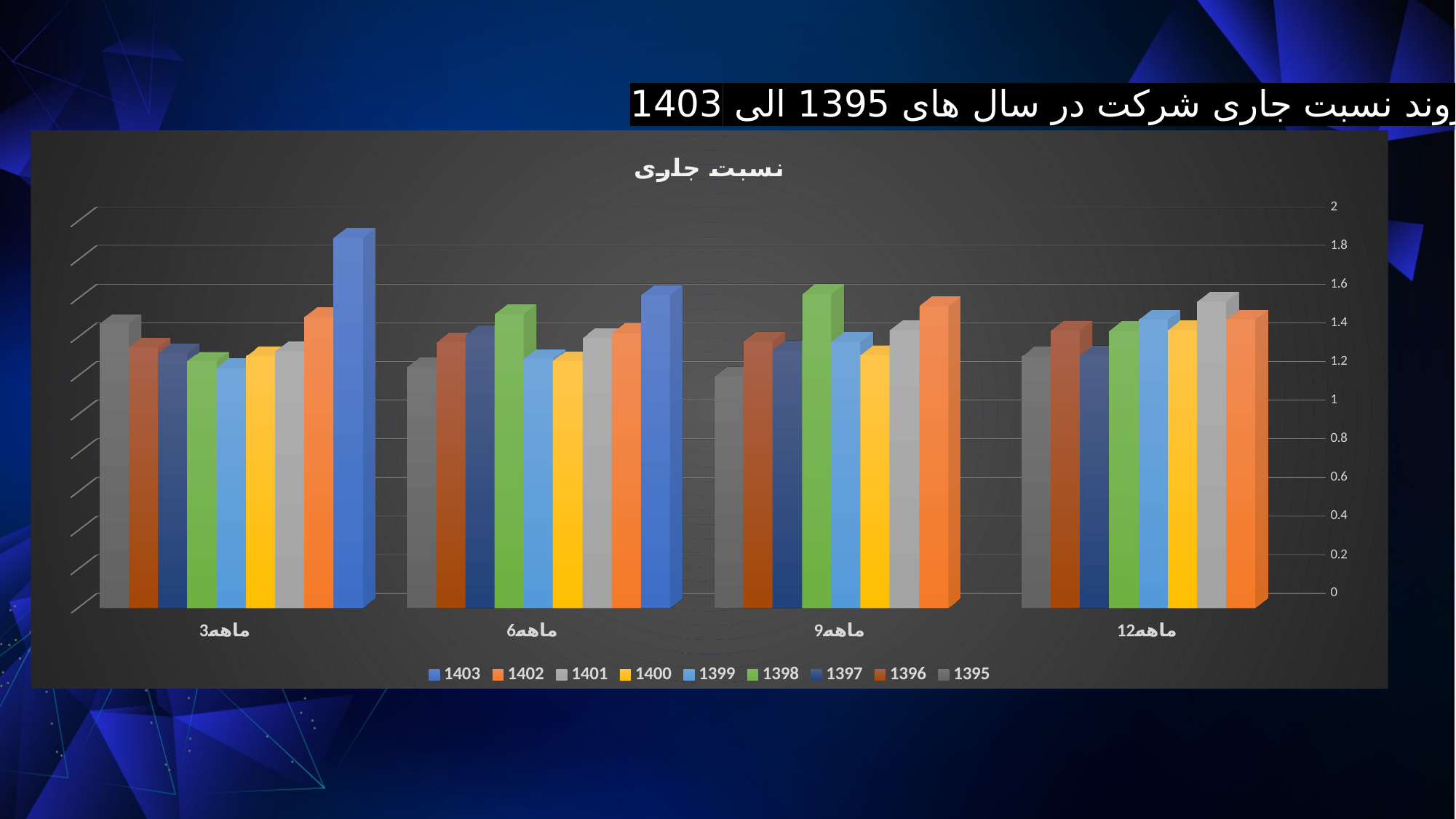
Which series has the highest value in the 9 ماهه category? 1398 How many categories are shown on the x axis? 4 Which series has the highest value in the 6 ماهه category? 1403 Is the value for 1403 in the 3 ماهه category greater or less than 1.6? greater Is the value for 1395 in the 9 ماهه category greater or less than 1.4? less What is the title of the chart? نسبت جاری Is the value for 1398 in the 9 ماهه category greater or less than 1.4? greater Which series has the highest value in the 3 ماهه category? 1403 Which is larger: the value for 1403 in 3 ماهه or the value for 1403 in 6 ماهه? 1403 in 3 ماهه What kind of chart is shown on the slide? bar chart How many series does the legend list? 9 How many bars are plotted in the 12 ماهه category? 8